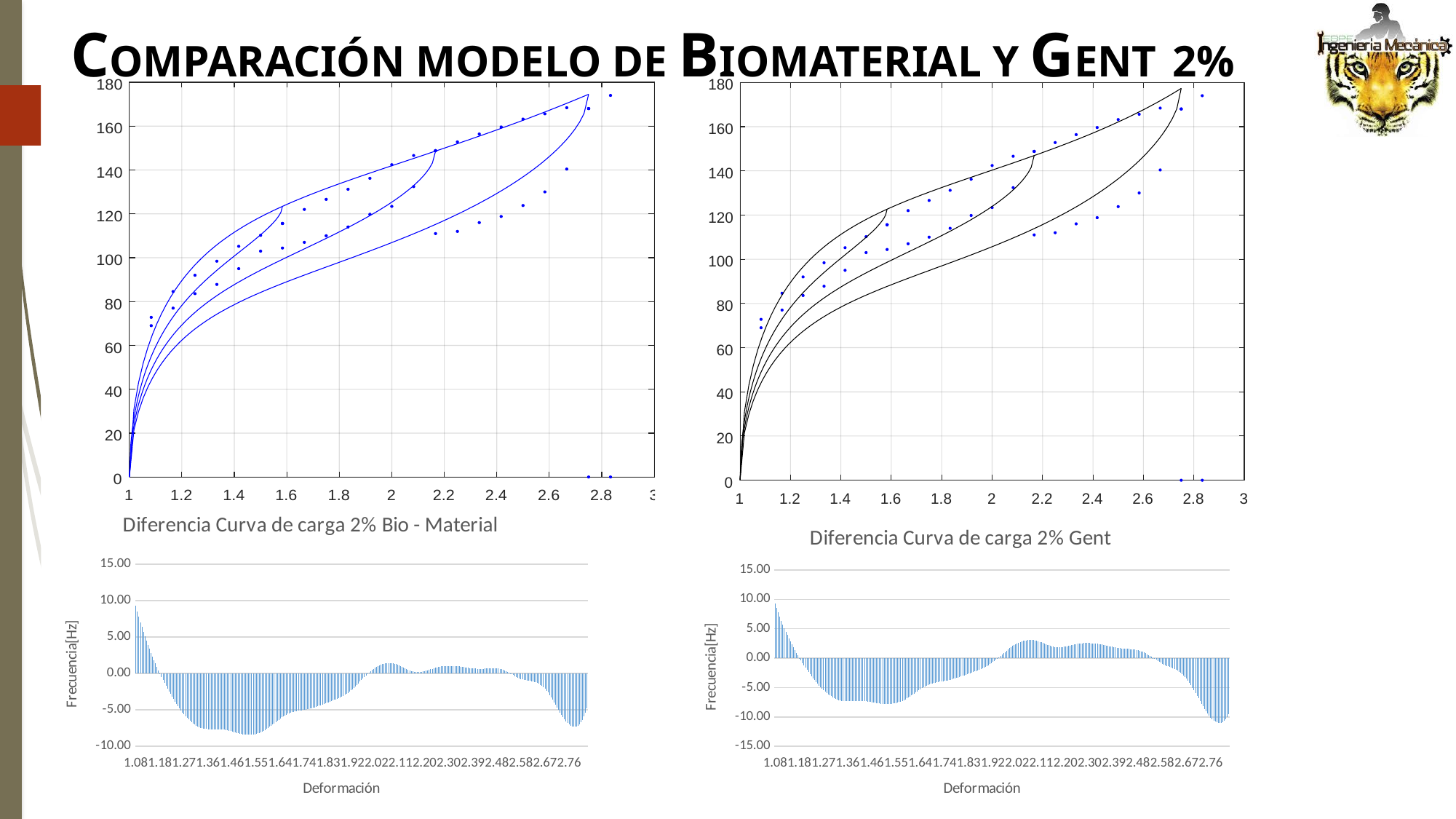
In the top-right chart with the black curves, do the curves rise or fall as the x-axis value increases from 1 to 2.8? rise In the bottom-right chart 'Diferencia Curva de carga 2% Gent', are the bars at the far right (around 2.76) greater or less than -5.00? less What colour are the curves in the top-right chart? black What kind of chart is the bottom-left chart titled 'Diferencia Curva de carga 2% Bio - Material'? bar chart In the top-left chart, is the highest plotted data point greater or less than 160? greater In the bottom-left chart 'Diferencia Curva de carga 2% Bio - Material', is the first bar (at 1.08) greater or less than 5.00? greater What kind of chart is the top-left chart with the blue curves? line chart What is the y-axis label of the bottom-left chart 'Diferencia Curva de carga 2% Bio - Material'? Frecuencia[Hz]